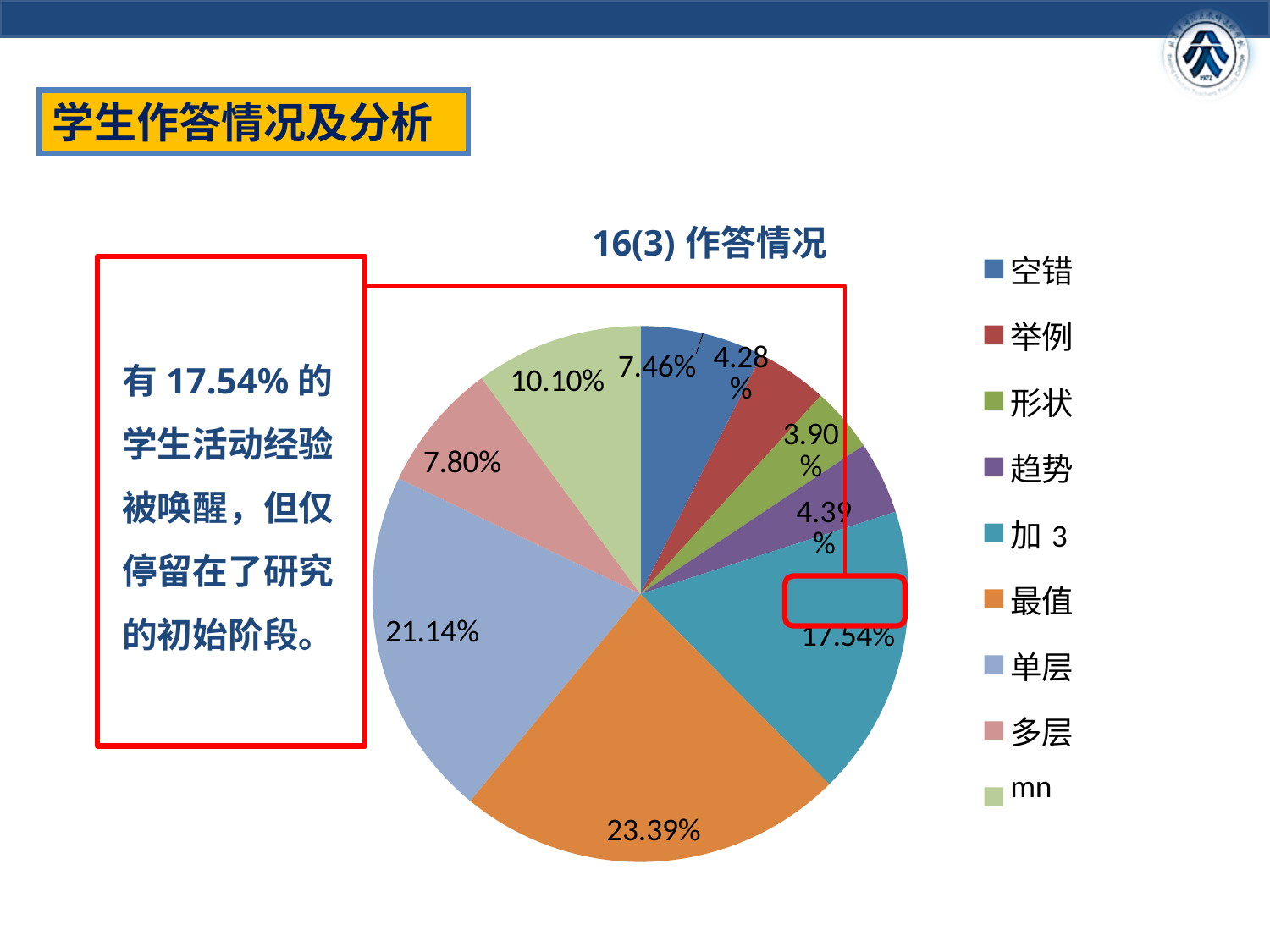
What is the title of the chart? 16(3) 作答情况 What share of the pie is mn? 10.10% Which category has the smallest slice? 形状 Which category has the largest slice? 最值 What share of the pie is 空错? 7.46% What share of the pie is 单层? 21.14% What is the difference between the shares of 最值 and 单层? 2.25% How many categories does the legend list? 9 What kind of chart is shown on the slide? pie chart Which is larger, the slice for 多层 or the slice for 空错? 多层